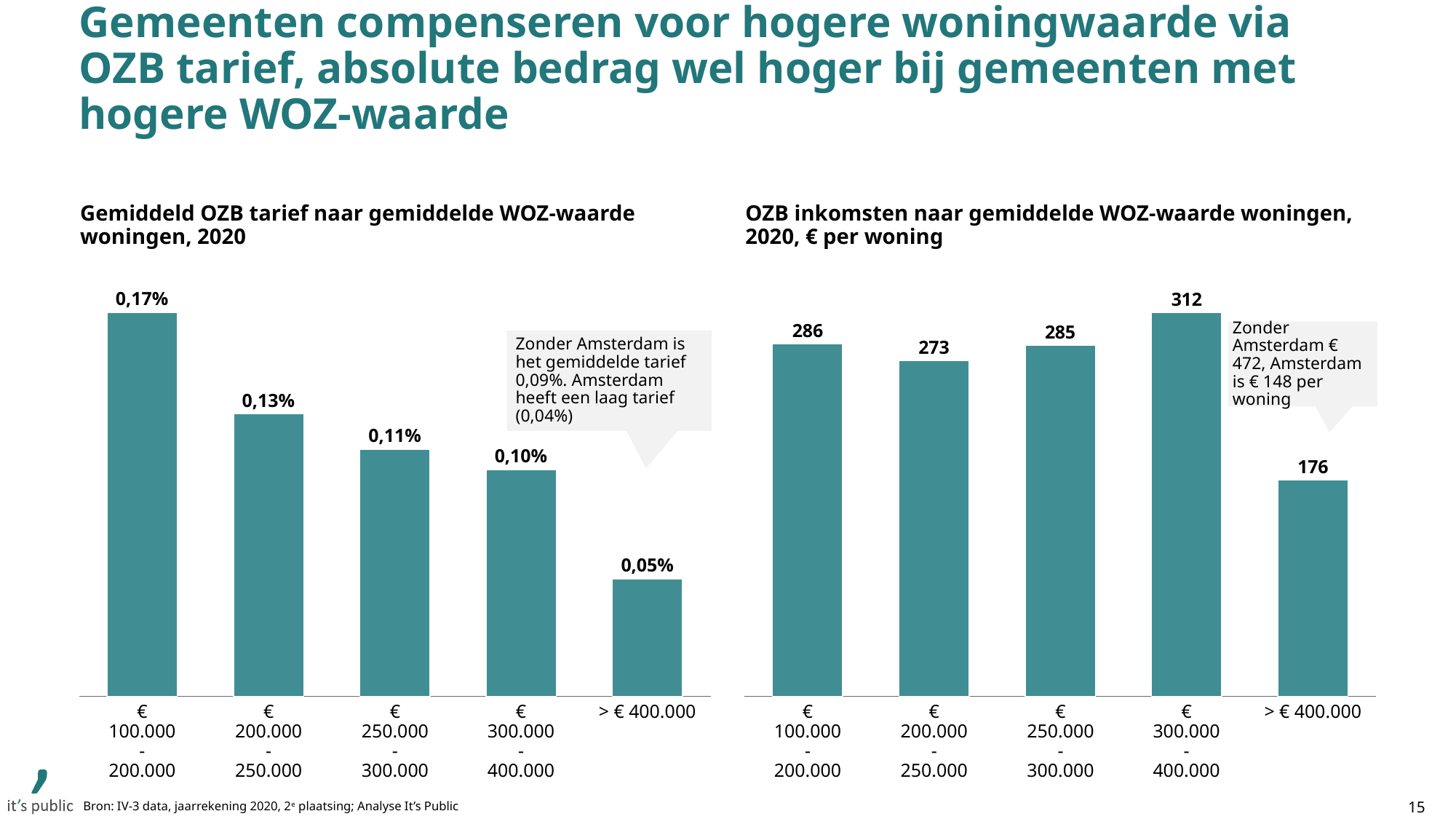
In the right chart 'OZB inkomsten naar gemiddelde WOZ-waarde woningen, 2020, € per woning', which category has the lowest value? > € 400.000 In the right chart 'OZB inkomsten naar gemiddelde WOZ-waarde woningen, 2020, € per woning', what is the value for € 200.000 - 250.000? 273 In the right chart 'OZB inkomsten naar gemiddelde WOZ-waarde woningen, 2020, € per woning', what is the value for € 300.000 - 400.000? 312 In the left chart 'Gemiddeld OZB tarief naar gemiddelde WOZ-waarde woningen, 2020', which category has the highest value? € 100.000 - 200.000 In the right chart 'OZB inkomsten naar gemiddelde WOZ-waarde woningen, 2020, € per woning', which is larger: the value for € 100.000 - 200.000 or the value for € 200.000 - 250.000? € 100.000 - 200.000 In the left chart 'Gemiddeld OZB tarief naar gemiddelde WOZ-waarde woningen, 2020', do the values rise or fall from left to right along the x axis? fall In the left chart 'Gemiddeld OZB tarief naar gemiddelde WOZ-waarde woningen, 2020', how many categories are shown? 5 What kind of chart is the right chart 'OZB inkomsten naar gemiddelde WOZ-waarde woningen, 2020, € per woning'? bar chart In the right chart 'OZB inkomsten naar gemiddelde WOZ-waarde woningen, 2020, € per woning', what is the difference between the values for € 300.000 - 400.000 and > € 400.000? 136 In the left chart 'Gemiddeld OZB tarief naar gemiddelde WOZ-waarde woningen, 2020', what is the value for > € 400.000? 0,05% In the left chart 'Gemiddeld OZB tarief naar gemiddelde WOZ-waarde woningen, 2020', what is the value for € 100.000 - 200.000? 0,17% According to the callout on the right chart, what is the OZB income per woning for Amsterdam? € 148